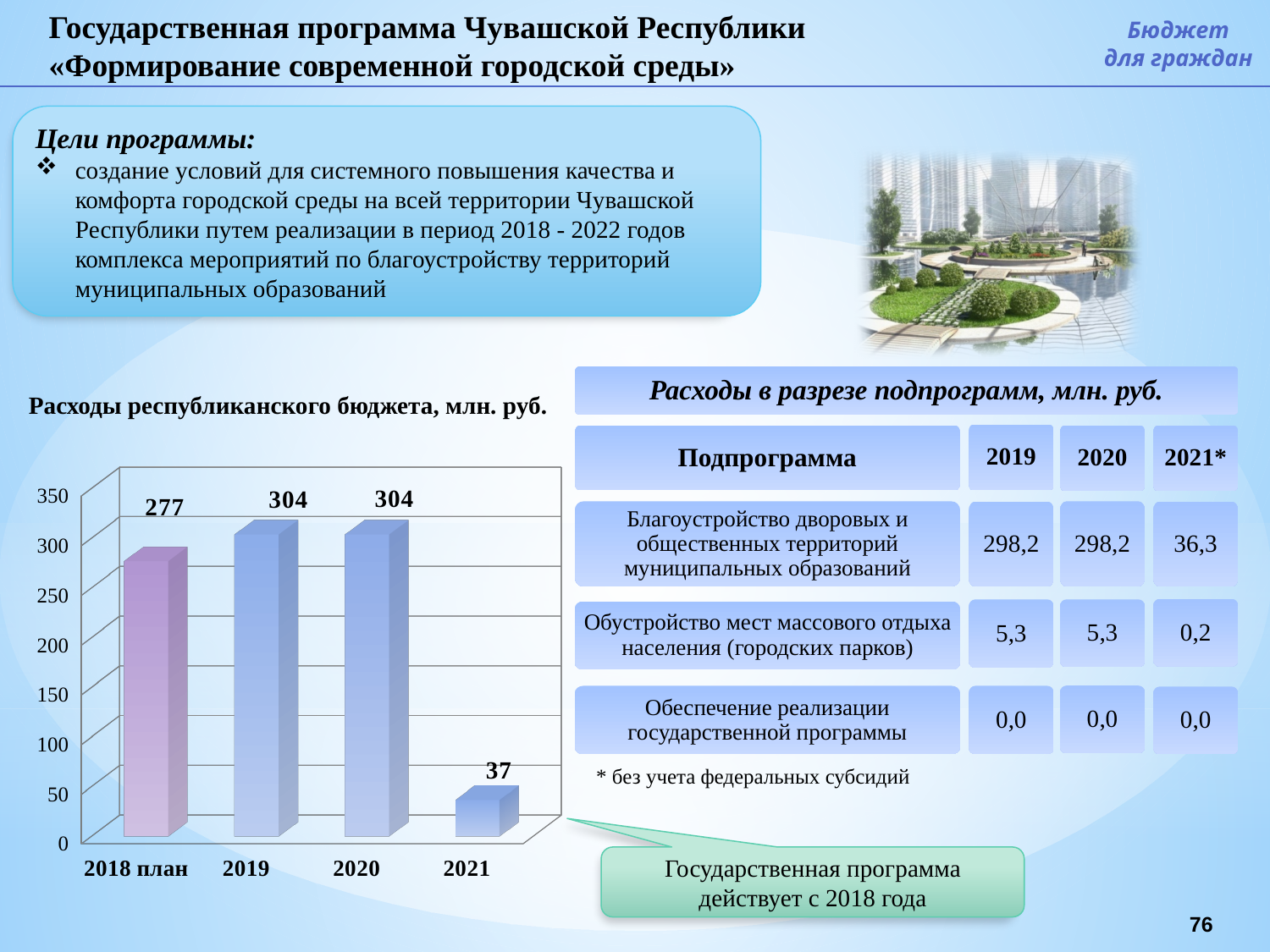
What is the difference between the values for 2020 and 2021 in the chart 'Расходы республиканского бюджета, млн. руб.'? 267 Is the value for 2018 план greater or less than 250 in the chart 'Расходы республиканского бюджета, млн. руб.'? greater Is the value for 2021 greater or less than 50 in the chart 'Расходы республиканского бюджета, млн. руб.'? less What is the value for 2021 in the chart 'Расходы республиканского бюджета, млн. руб.'? 37 Which is larger in the chart 'Расходы республиканского бюджета, млн. руб.': the value for 2018 план or the value for 2021? 2018 план What is the value for 2019 in the chart 'Расходы республиканского бюджета, млн. руб.'? 304 What is the value for 2018 план in the chart 'Расходы республиканского бюджета, млн. руб.'? 277 What is the title of the chart on the left side of the slide? Расходы республиканского бюджета, млн. руб. How many categories are shown in the chart 'Расходы республиканского бюджета, млн. руб.'? 4 What kind of chart is 'Расходы республиканского бюджета, млн. руб.'? bar chart Which category has the lowest value in the chart 'Расходы республиканского бюджета, млн. руб.'? 2021 What is the difference between the values for 2019 and 2018 план in the chart 'Расходы республиканского бюджета, млн. руб.'? 27